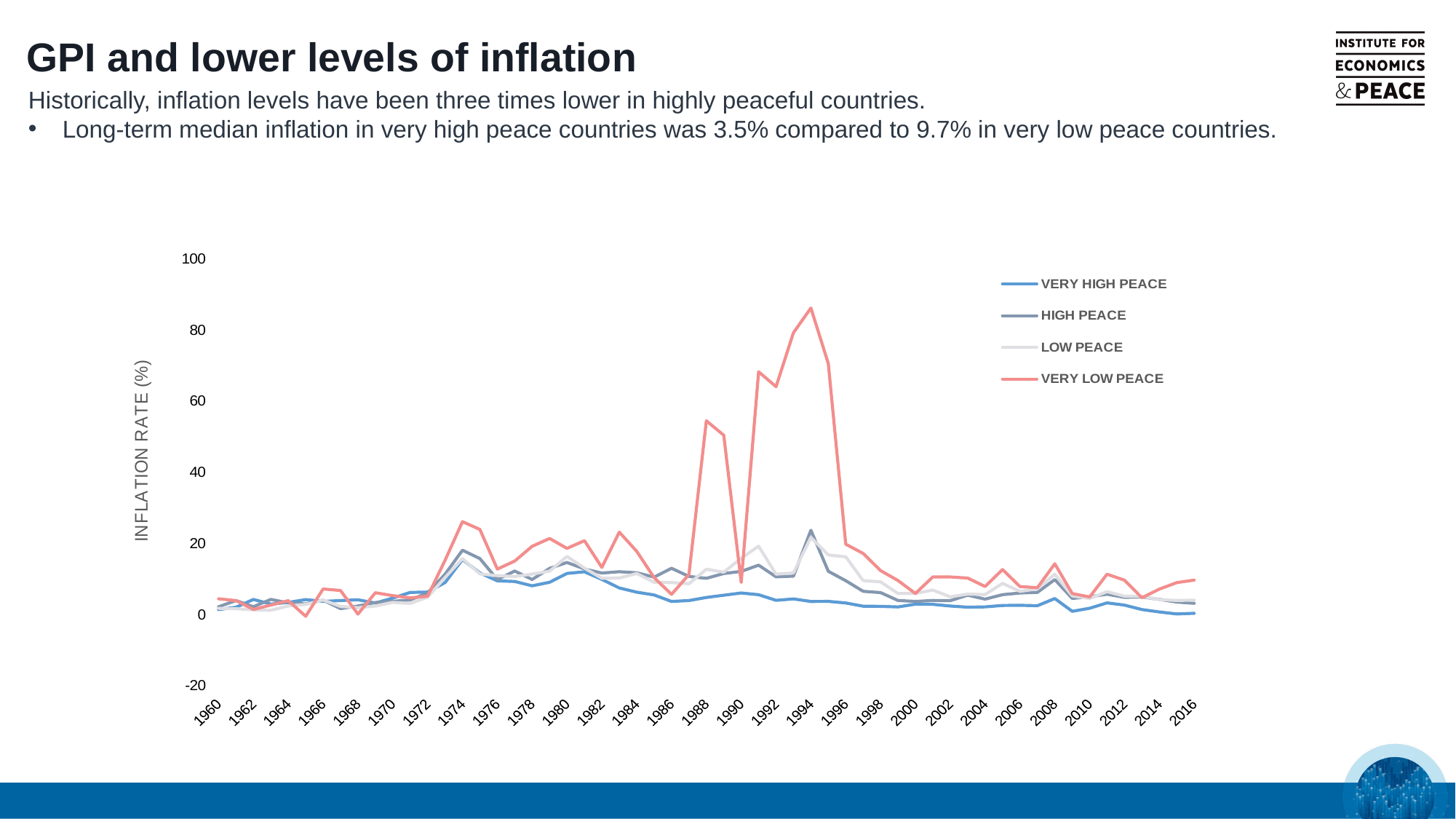
Is the value for VERY LOW PEACE in 1988 greater or less than 40? greater Is the value for HIGH PEACE in 1994 greater or less than 40? less Is the value for VERY LOW PEACE in 1994 greater or less than 80? greater What is the title of the y axis? INFLATION RATE (%) In 1994, which is larger: VERY LOW PEACE or VERY HIGH PEACE? VERY LOW PEACE Which series reaches the highest inflation rate on the chart? VERY LOW PEACE Does the VERY LOW PEACE line rise or fall between 1994 and 1996? fall Which series stays lowest across most of the chart? VERY HIGH PEACE How many series does the legend list? 4 What kind of chart is shown on the slide? line chart How many year labels are shown on the x axis? 29